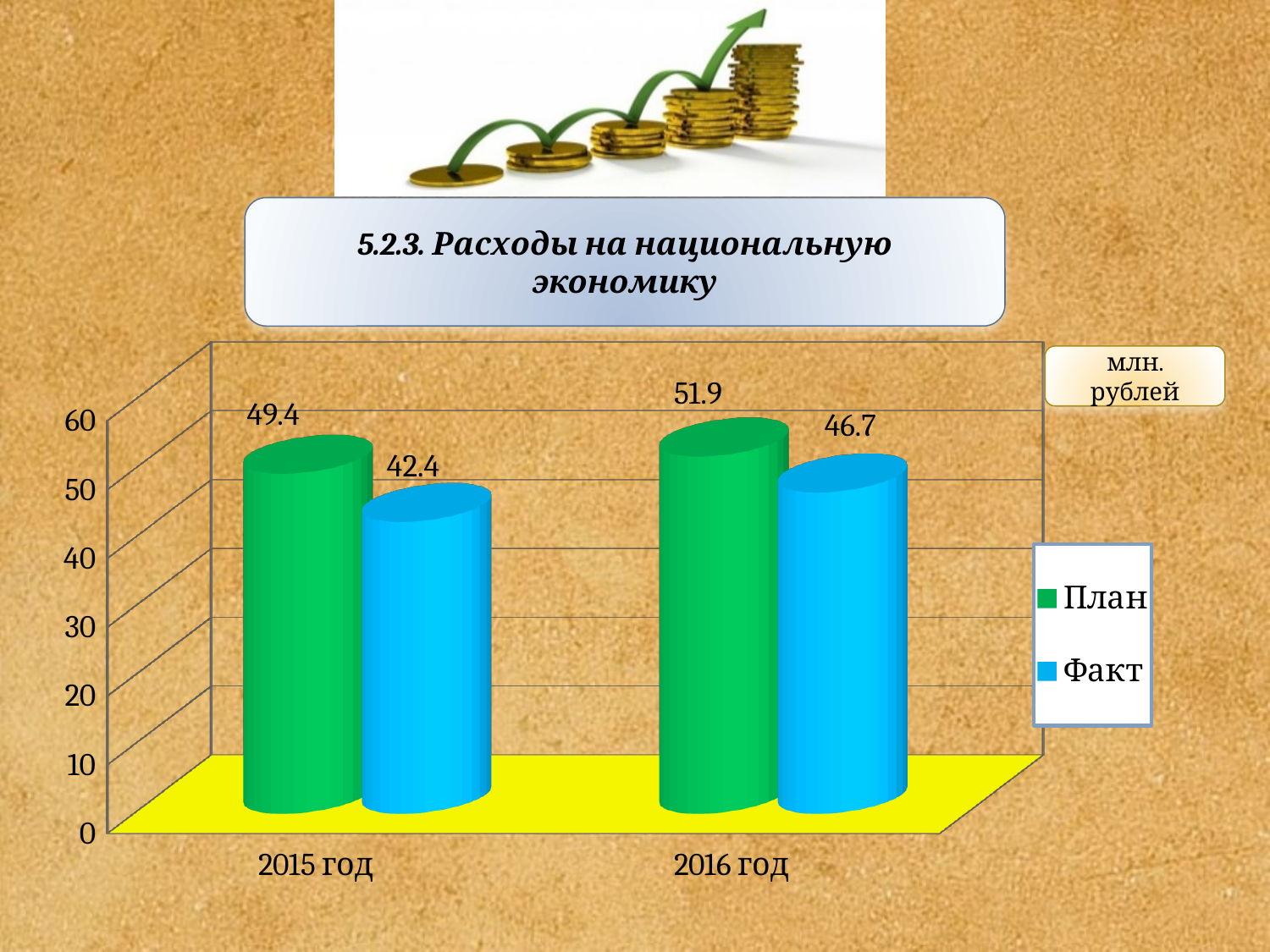
How many years are shown on the x axis? 2 What is the Факт value for 2015 год? 42.4 Which year has the lowest Факт value? 2015 год What is the difference between План and Факт for 2016 год? 5.2 Which is larger in 2015 год, План or Факт? План What kind of chart is shown on the slide? bar chart How many series does the legend list? 2 Which year has the highest План value? 2016 год What is the План value for 2015 год? 49.4 What unit is indicated for the chart values? млн. рублей What is the difference between the Факт values for 2016 год and 2015 год? 4.3 What is the Факт value for 2016 год? 46.7